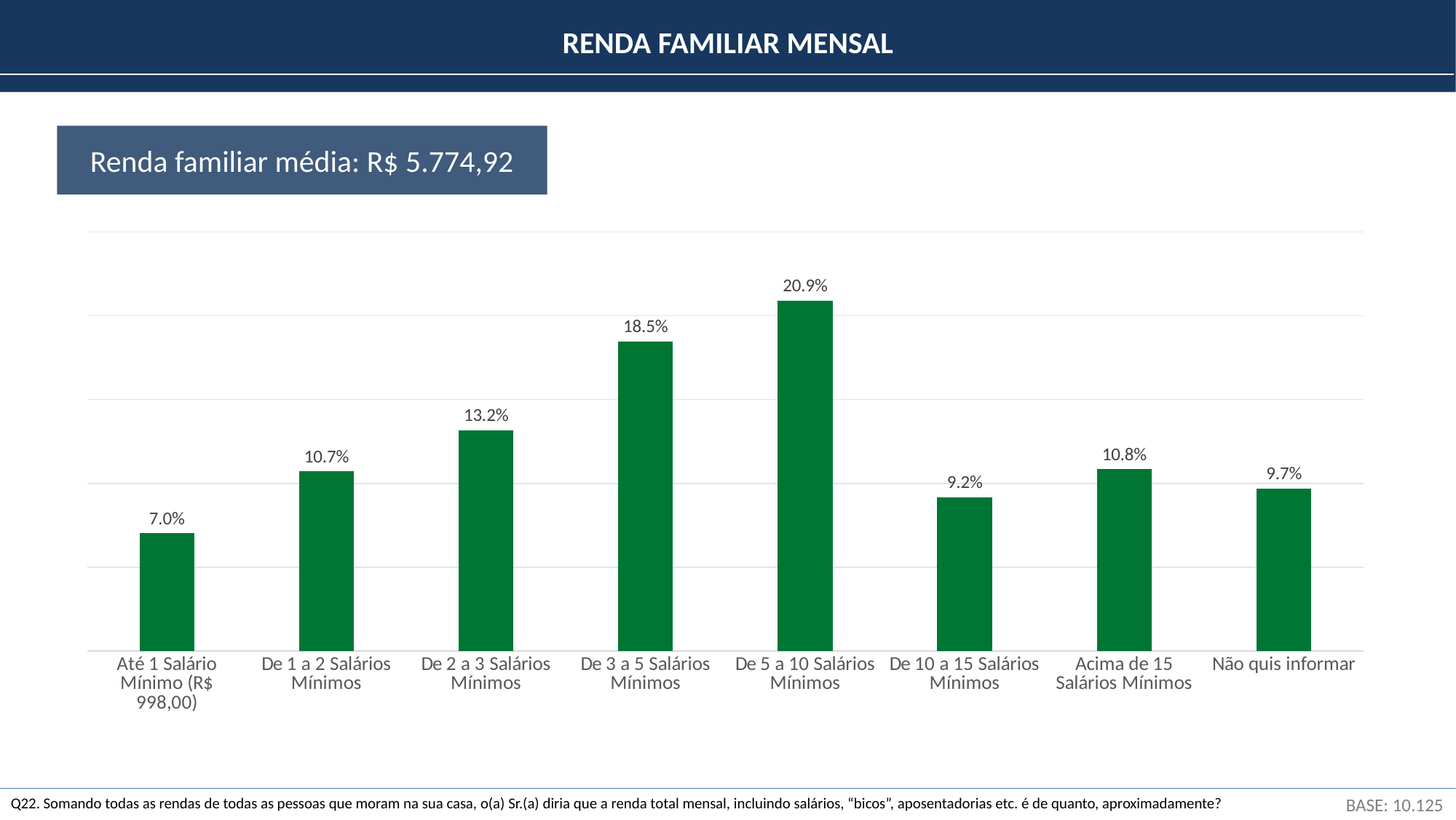
What is the value for 'De 5 a 10 Salários Mínimos'? 20.9% Which category has the highest value? De 5 a 10 Salários Mínimos Which is larger, 'De 3 a 5 Salários Mínimos' or 'De 2 a 3 Salários Mínimos'? De 3 a 5 Salários Mínimos Which category has the lowest value? Até 1 Salário Mínimo (R$ 998,00) What kind of chart is shown on the slide? Bar chart What is the value for 'Até 1 Salário Mínimo (R$ 998,00)'? 7.0% How many categories are shown on the x axis? 8 What is the difference between 'De 2 a 3 Salários Mínimos' and 'De 1 a 2 Salários Mínimos'? 2.5% Which is larger, 'De 10 a 15 Salários Mínimos' or 'Acima de 15 Salários Mínimos'? Acima de 15 Salários Mínimos What is the difference between 'De 5 a 10 Salários Mínimos' and 'De 3 a 5 Salários Mínimos'? 2.4% What is the average family income stated in the box above the chart? R$ 5.774,92 What is the value for 'Não quis informar'? 9.7%